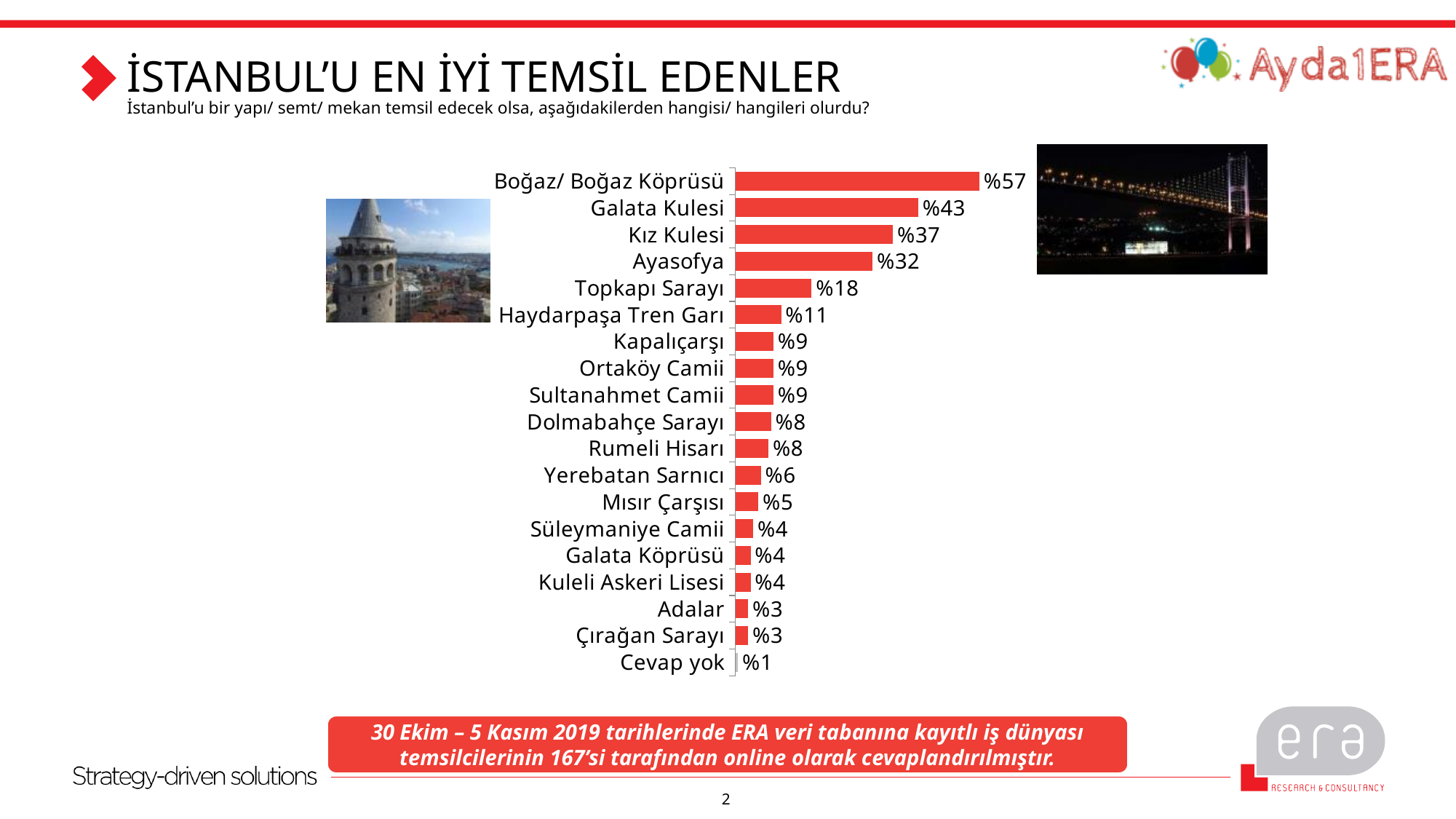
What is the difference between the values for Boğaz/ Boğaz Köprüsü and Topkapı Sarayı? %39 What is the value for Haydarpaşa Tren Garı? %11 What colour are the bars in the chart? Red How many categories are shown in the chart? 19 What is the difference between the values for Galata Kulesi and Kız Kulesi? %6 Which is larger, the value for Yerebatan Sarnıcı or the value for Mısır Çarşısı? Yerebatan Sarnıcı Which category has the lowest value? Cevap yok What kind of chart is shown on the slide? Bar chart What is the value for Ayasofya? %32 What is the value for Boğaz/ Boğaz Köprüsü? %57 Which category has the highest value? Boğaz/ Boğaz Köprüsü Which is larger, the value for Ayasofya or the value for Topkapı Sarayı? Ayasofya